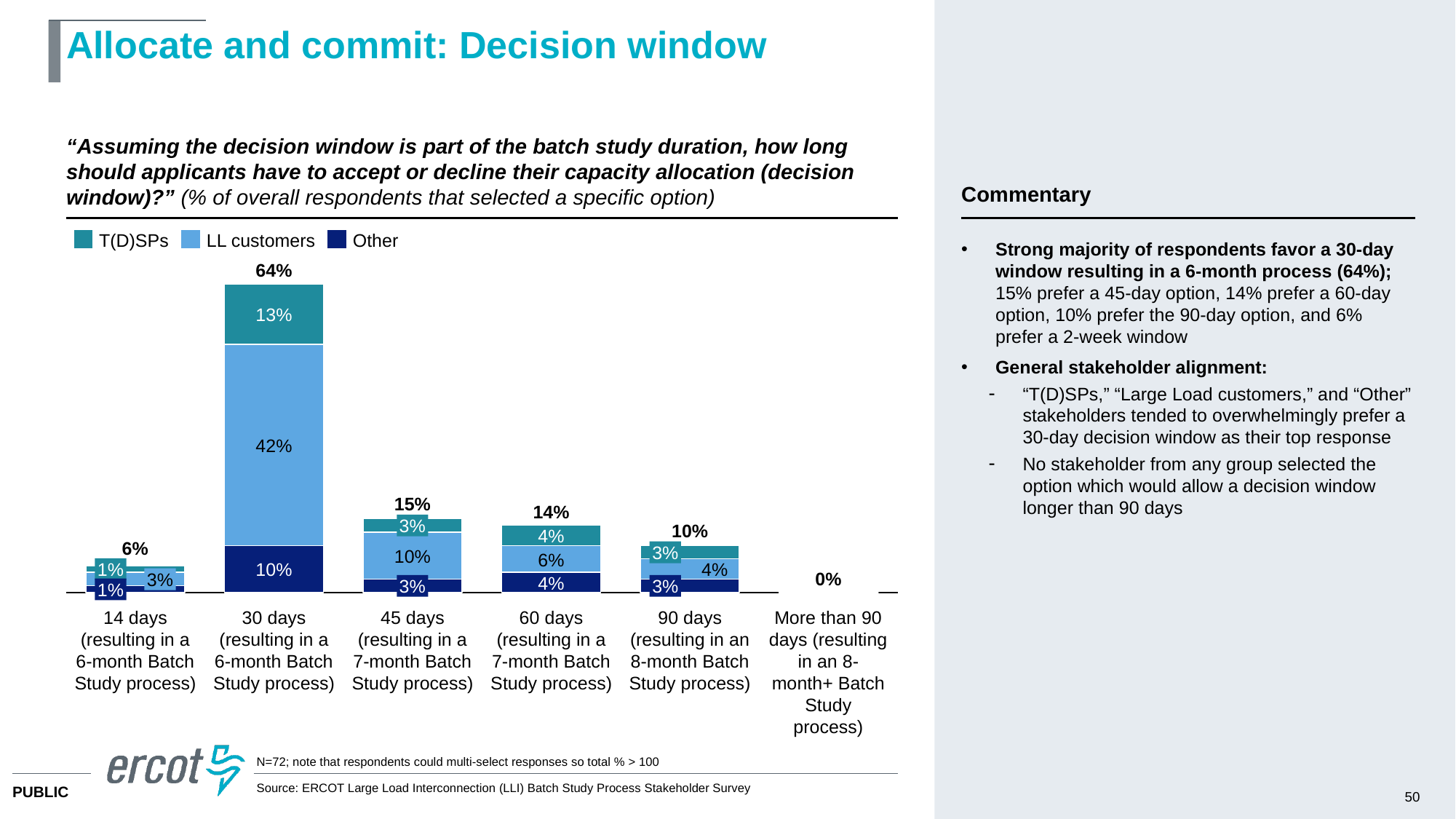
Which decision-window option has the highest overall percentage? 30 days (resulting in a 6-month Batch Study process) What is the overall percentage of respondents who selected the 30 days option? 64% How many series does the legend list? 3 What kind of chart is shown on the slide? Stacked bar chart Which series is shown in the darkest blue colour in the legend? Other Which decision-window option has the lowest overall percentage? More than 90 days (resulting in an 8-month+ Batch Study process) What is the difference between the overall percentage for 30 days and the overall percentage for 45 days? 49% Which has a larger overall percentage, the 60 days option or the 90 days option? 60 days What percentage of respondents in the LL customers series selected the 30 days option? 42% How many decision-window options (categories) are shown on the x axis? 6 What is the Other value for the 45 days option? 3% What is the T(D)SPs value for the 60 days option? 4%